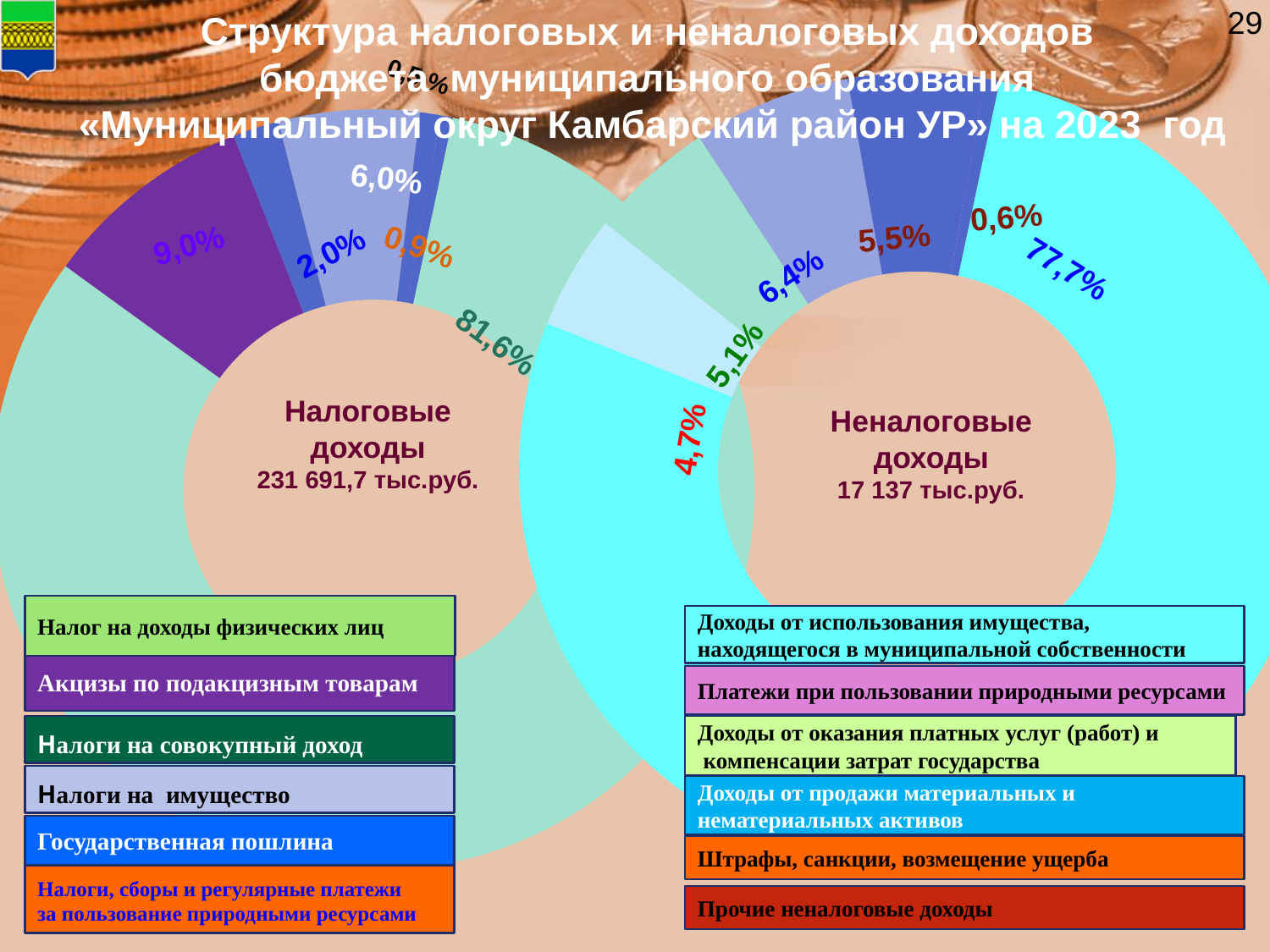
In the 'Налоговые доходы' chart, what share is shown for 'Налоги на имущество'? 6,0% In the 'Неналоговые доходы' chart, what share is shown for 'Доходы от использования имущества, находящегося в муниципальной собственности'? 77,7% In the 'Налоговые доходы' chart, by how many percentage points does the share of 'Налог на доходы физических лиц' exceed the share of 'Акцизы по подакцизным товарам'? 72,6 percentage points What kind of chart is used on this slide to show the structure of tax and non-tax revenues? Pie (doughnut) chart In the 'Налоговые доходы' chart, what share is shown for 'Акцизы по подакцизным товарам'? 9,0% In the 'Налоговые доходы' chart, which category has the largest share? Налог на доходы физических лиц How many categories are listed in the legend of the 'Неналоговые доходы' chart? 6 In the 'Неналоговые доходы' chart, what is the smallest share shown? 0,6% In the 'Неналоговые доходы' chart, which is larger: the slice labelled 6,4% or the slice labelled 5,5%? 6,4% What total amount is shown in the centre of the 'Неналоговые доходы' chart? 17 137 тыс.руб. What total amount is shown in the centre of the 'Налоговые доходы' chart? 231 691,7 тыс.руб.